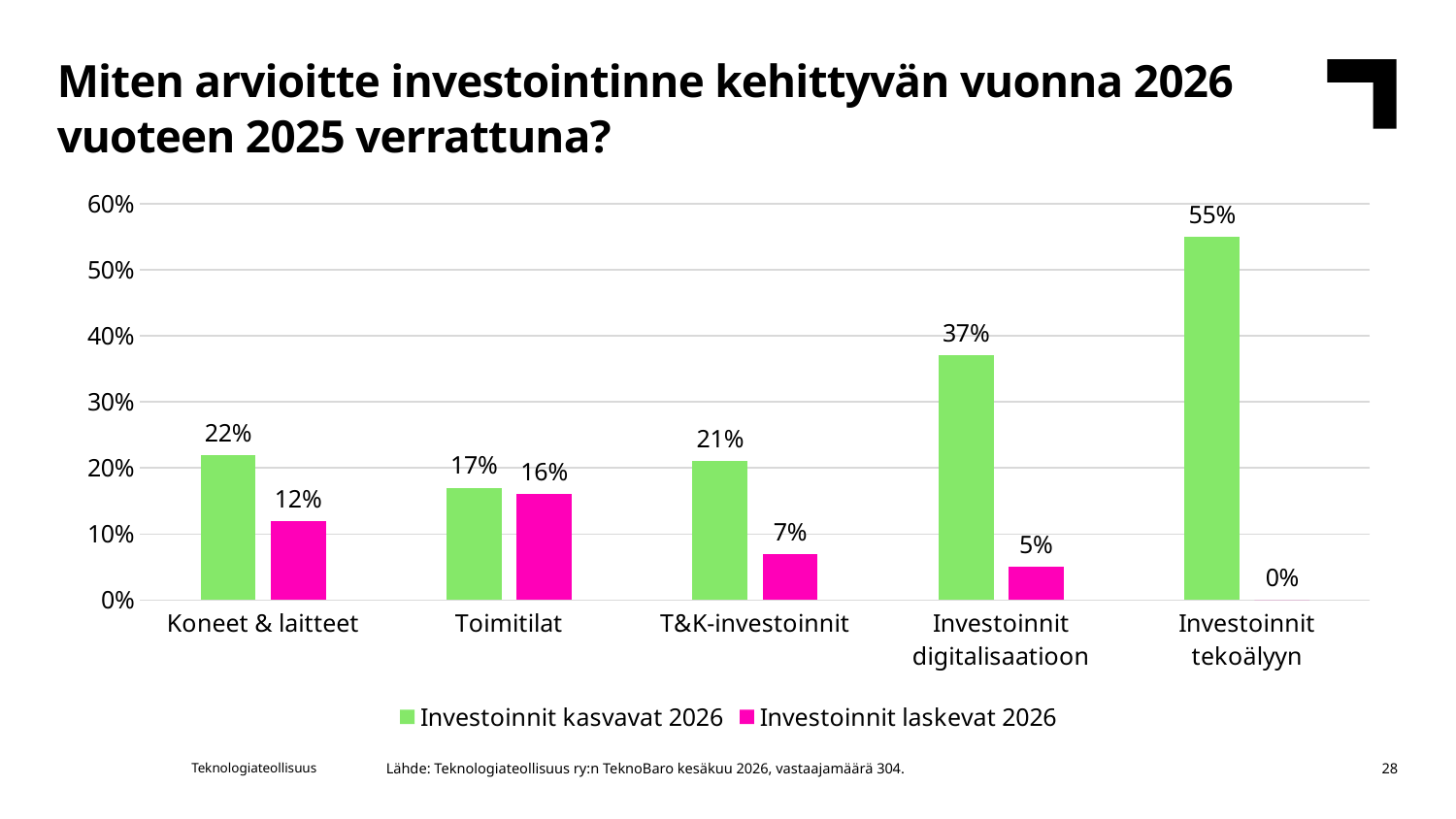
What is the value for 'Investoinnit kasvavat 2026' in the 'T&K-investoinnit' category? 21% How many series does the legend list? 2 Which category has the lowest value for 'Investoinnit laskevat 2026'? Investoinnit tekoälyyn What is the value for 'Investoinnit kasvavat 2026' in the 'Investoinnit tekoälyyn' category? 55% What is the difference between 'Investoinnit kasvavat 2026' and 'Investoinnit laskevat 2026' for 'Investoinnit digitalisaatioon'? 32% How many categories are shown on the x axis? 5 Which category has the highest value for 'Investoinnit kasvavat 2026'? Investoinnit tekoälyyn What is the value for 'Investoinnit laskevat 2026' in the 'Koneet & laitteet' category? 12% What kind of chart is shown on the slide? Bar chart What colour are the bars for 'Investoinnit laskevat 2026'? Magenta (pink) Which is larger for 'Toimitilat': 'Investoinnit kasvavat 2026' or 'Investoinnit laskevat 2026'? Investoinnit kasvavat 2026 Is the value for 'Investoinnit kasvavat 2026' in 'Investoinnit digitalisaatioon' greater or less than 30%? greater